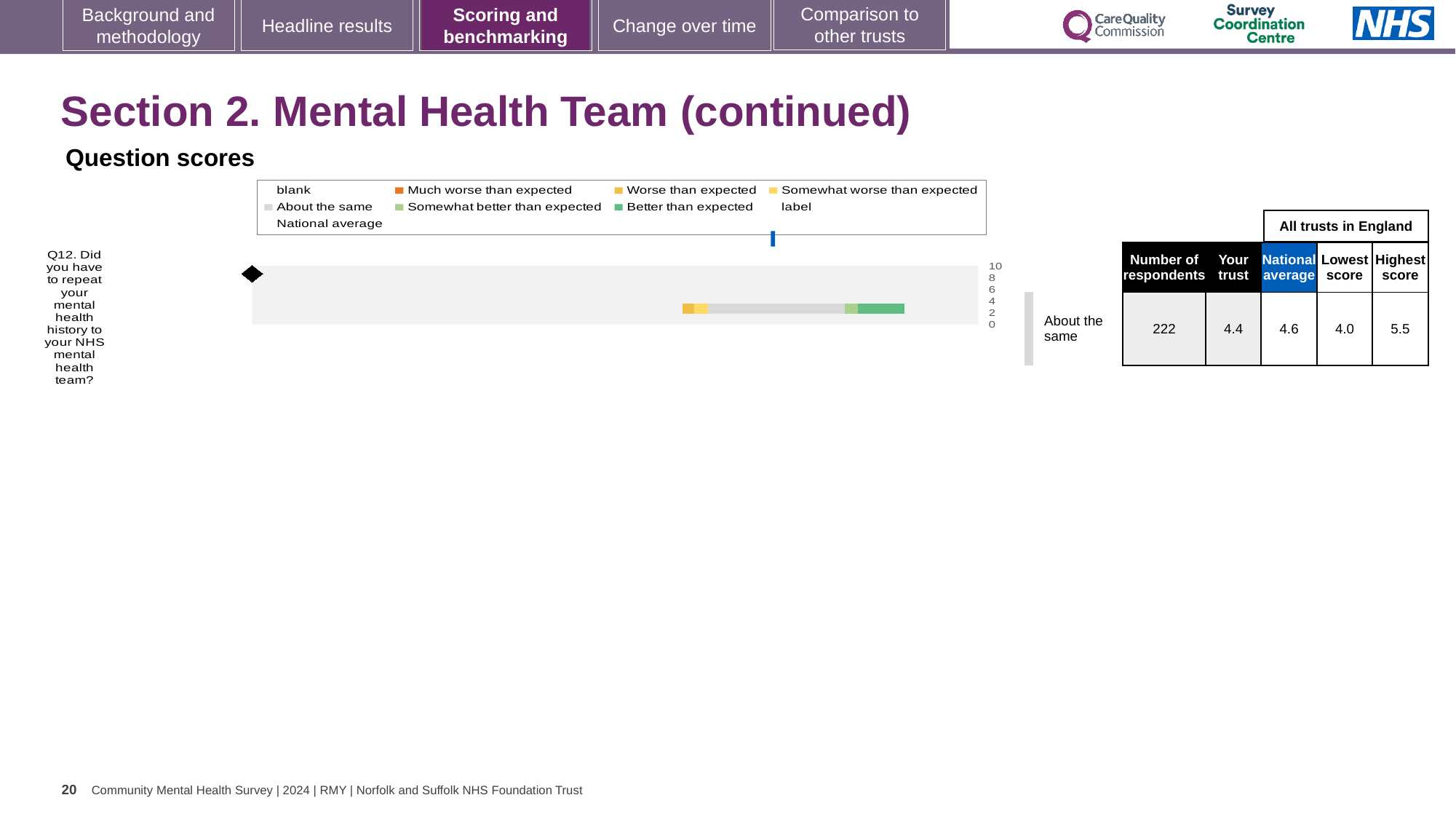
Which is larger for Q12: the 'Your trust' score or the national average? National average What is the national average score for Q12? 4.6 How many survey questions are plotted on the chart? 1 What kind of chart is used to show the Q12 question score? bar chart How many respondents answered Q12? 222 What is the highest score among all trusts in England for Q12? 5.5 What is the lowest score among all trusts in England for Q12? 4.0 What is the difference between the highest and lowest scores for Q12? 1.5 What does the blue marker in the legend represent? National average By how much does the national average exceed the 'Your trust' score for Q12? 0.2 What benchmark category is the trust's Q12 score placed in? About the same What is the 'Your trust' score for Q12? 4.4